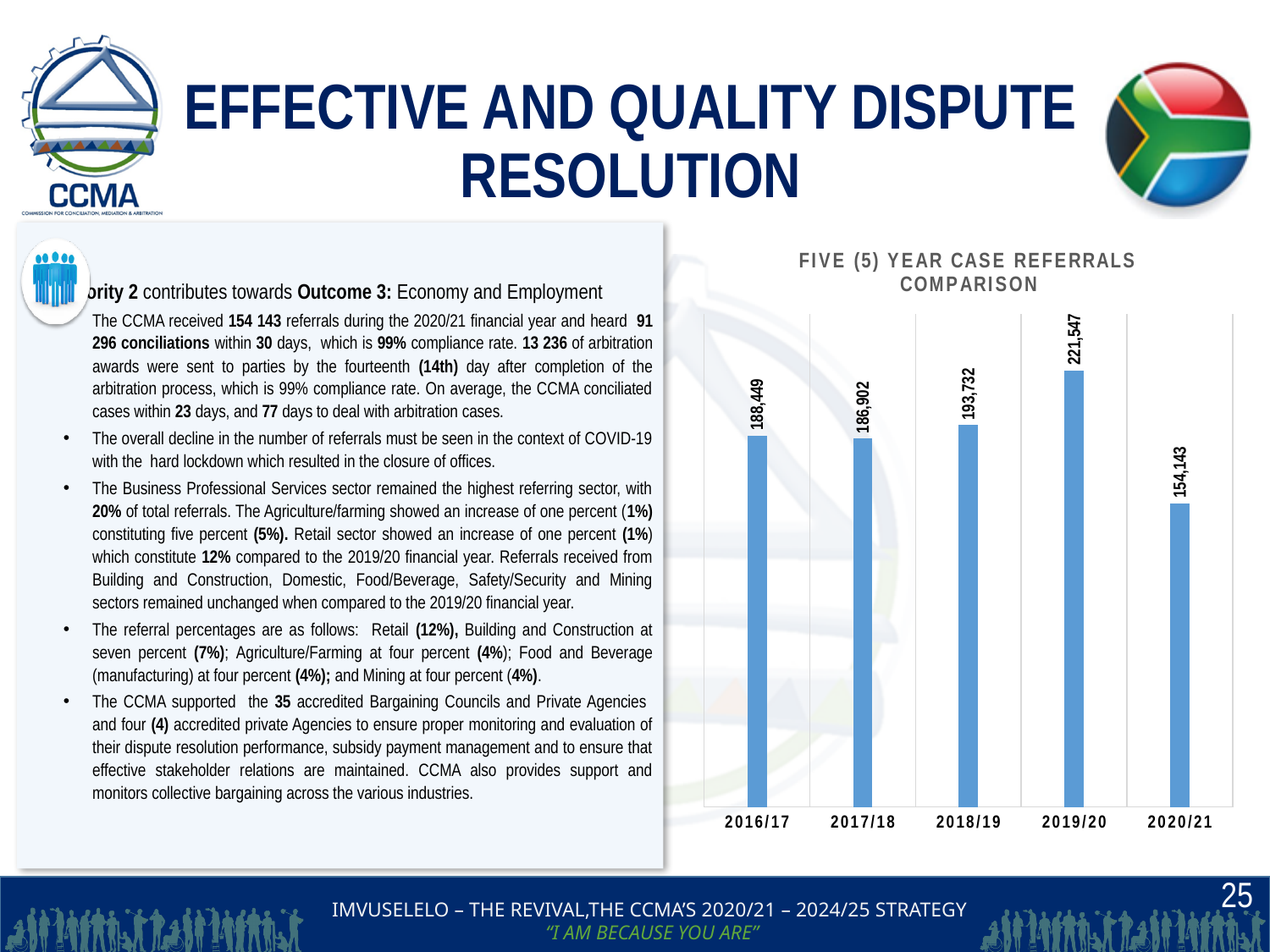
How many years are shown in the Five (5) Year Case Referrals Comparison chart? 5 Which is larger, the value for 2018/19 or the value for 2020/21? 2018/19 What is the value for 2020/21 in the Five (5) Year Case Referrals Comparison chart? 154,143 What is the value for 2019/20 in the Five (5) Year Case Referrals Comparison chart? 221,547 What is the difference between the case referrals for 2019/20 and 2020/21? 67,404 What kind of chart is the Five (5) Year Case Referrals Comparison? Bar chart Which year has the highest number of case referrals in the chart? 2019/20 What is the value for 2016/17 in the Five (5) Year Case Referrals Comparison chart? 188,449 What is the difference between the case referrals for 2018/19 and 2017/18? 6,830 What is the title of the chart on the slide? FIVE (5) YEAR CASE REFERRALS COMPARISON Which year has the lowest number of case referrals in the chart? 2020/21 What is the value for 2018/19 in the Five (5) Year Case Referrals Comparison chart? 193,732